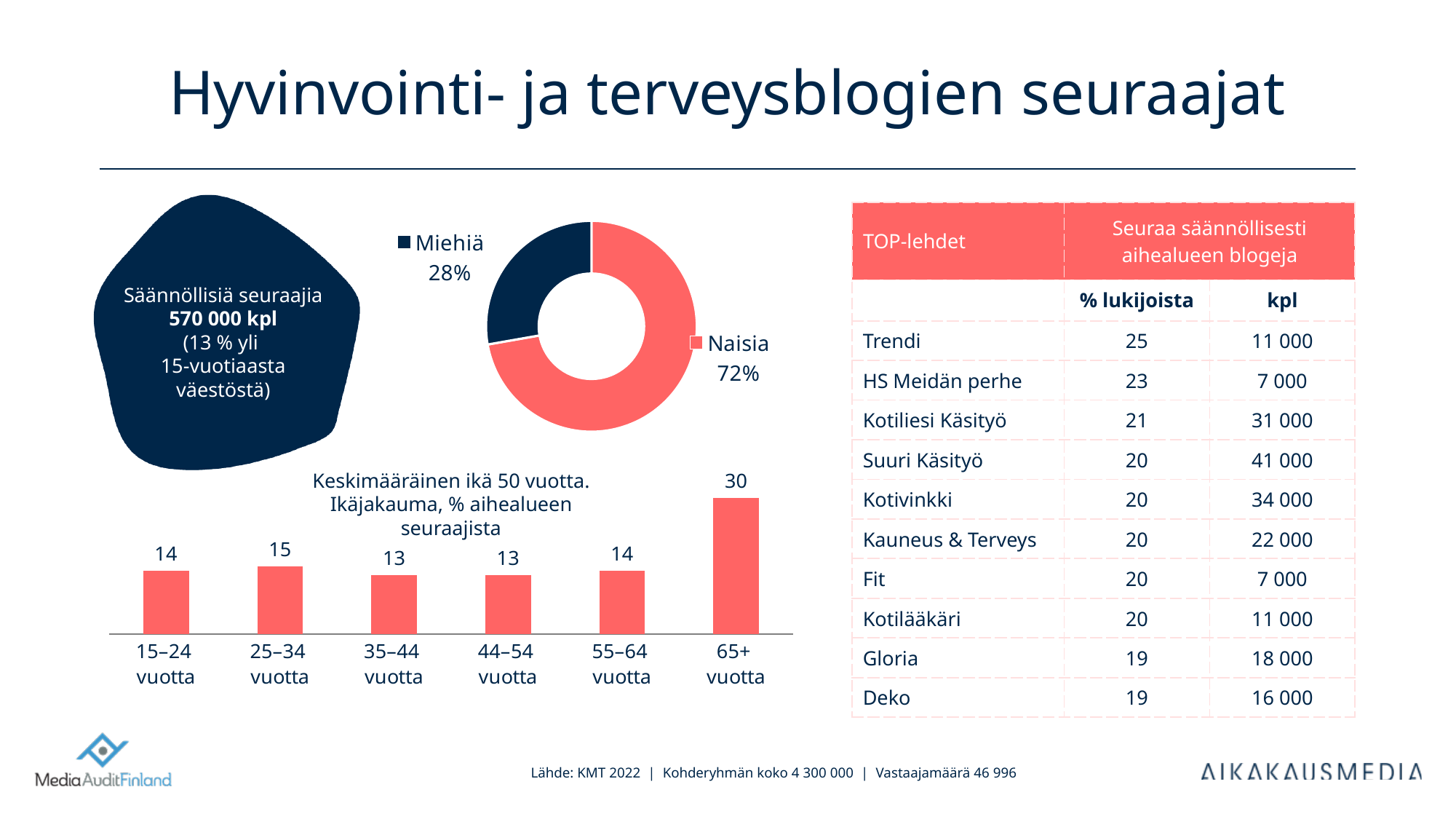
In the age distribution bar chart, which age group has the highest value? 65+ vuotta In the age distribution bar chart, which is larger, the value for 25–34 vuotta or 35–44 vuotta? 25–34 vuotta In the donut chart, which segment is larger, Miehiä or Naisia? Naisia In the age distribution bar chart, what is the value for 25–34 vuotta? 15 In the donut chart, what share is Naisia? 72% How many segments does the donut chart have? 2 In the age distribution bar chart, what is the value for 65+ vuotta? 30 What kind of chart shows the age distribution (Ikäjakauma)? Bar chart In the age distribution bar chart, what is the difference between the values for 65+ vuotta and 15–24 vuotta? 16 How many age groups are shown in the age distribution bar chart? 6 In the donut chart, what colour is the Miehiä segment? Dark navy blue In the donut chart, what share is Miehiä? 28%